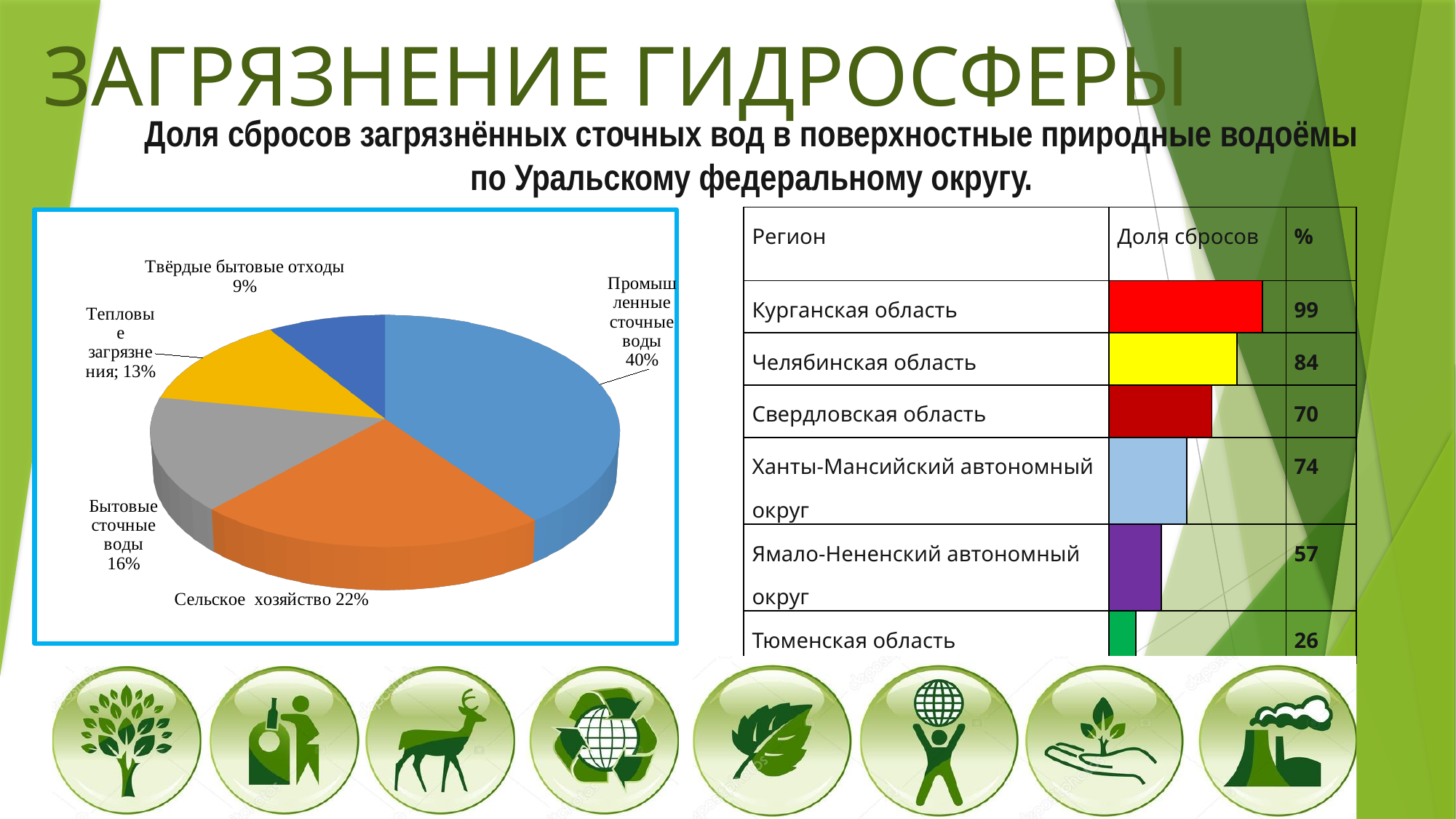
In the pie chart, what share is labelled for Промышленные сточные воды? 40% What kind of chart is shown on the left of the slide? pie chart In the pie chart, how many slices are there? 5 In the pie chart, what is the difference in percentage points between Промышленные сточные воды and Сельское хозяйство? 18 In the pie chart, what share is labelled for Бытовые сточные воды? 16% In the pie chart, which is larger: Бытовые сточные воды or Тепловые загрязнения? Бытовые сточные воды In the pie chart, which category has the smallest slice? Твёрдые бытовые отходы In the pie chart, what share is labelled for Твёрдые бытовые отходы? 9% In the pie chart, what share is labelled for Тепловые загрязнения? 13% In the pie chart, what share is labelled for Сельское хозяйство? 22% In the table on the right, which region has the highest share of discharges (%)? Курганская область In the pie chart, which category has the largest slice? Промышленные сточные воды